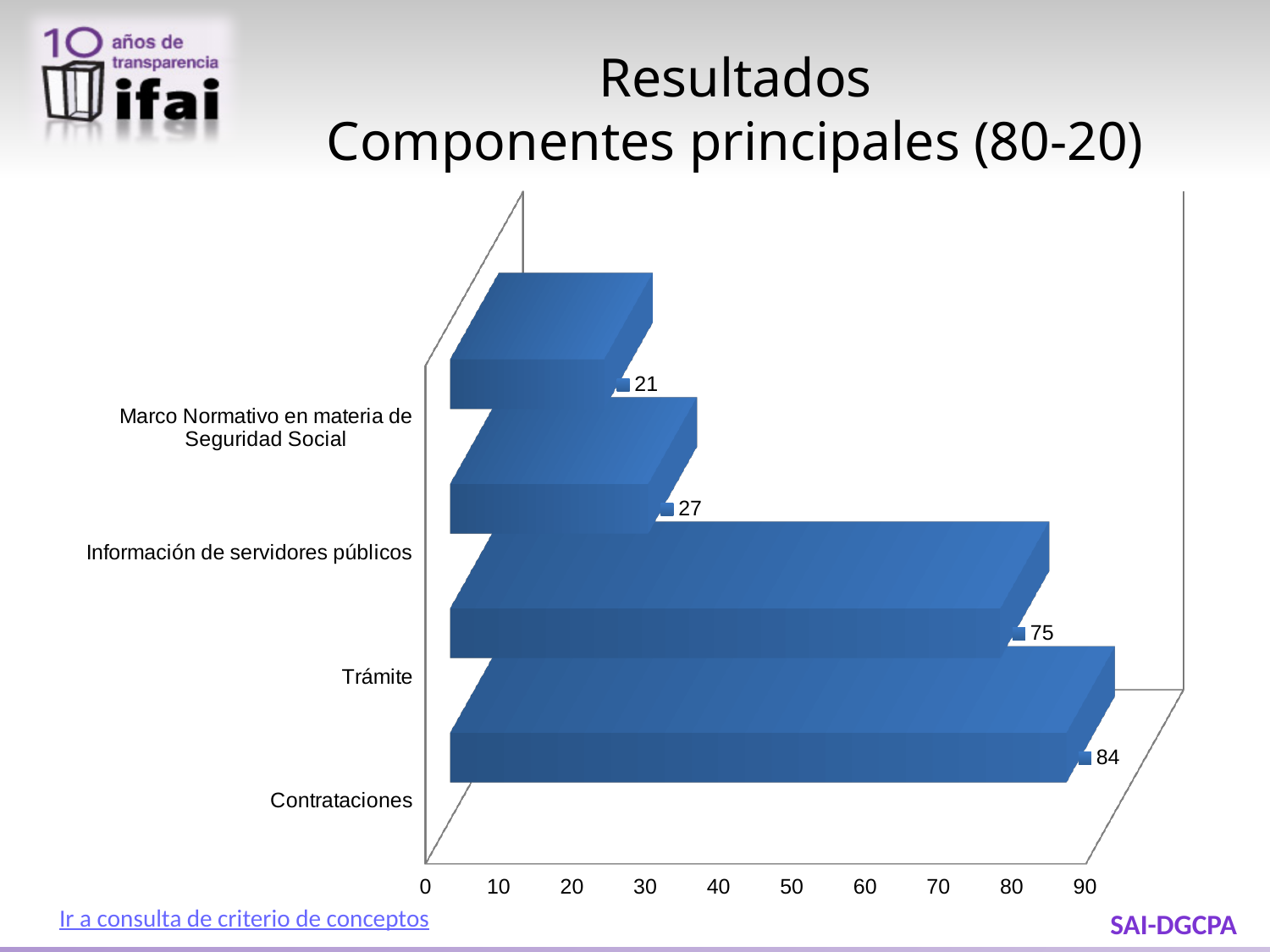
What kind of chart is shown on the slide? Bar chart What is the difference between the values for Contrataciones and Trámite? 9 What is the highest value shown on the horizontal axis? 90 Which category has the lowest value? Marco Normativo en materia de Seguridad Social Which category has the highest value? Contrataciones What is the value for Contrataciones? 84 What is the value for Trámite? 75 Which is larger, the value for Trámite or the value for Información de servidores públicos? Trámite What is the difference between the values for Información de servidores públicos and Marco Normativo en materia de Seguridad Social? 6 What is the value for Información de servidores públicos? 27 How many categories are shown in the chart? 4 What is the value for Marco Normativo en materia de Seguridad Social? 21